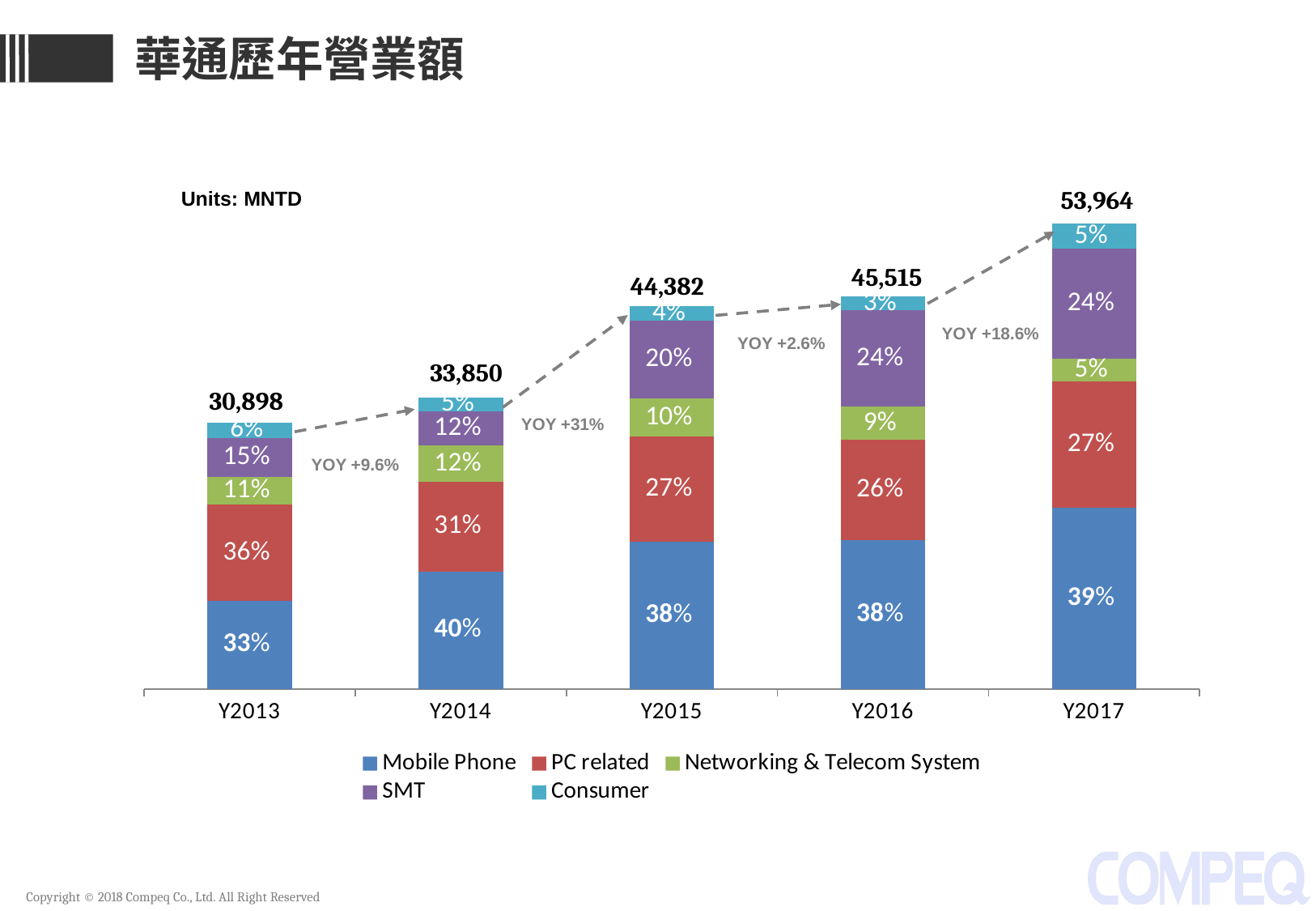
What percentage share does Mobile Phone have in Y2014? 40% Which year has the lowest total revenue? Y2013 What percentage share does SMT have in Y2016? 24% How many series does the legend list? 5 How many years are shown on the x axis? 5 What kind of chart is shown on the slide? Stacked bar chart Do the total revenue values rise or fall from Y2013 to Y2017? Rise What percentage share does PC related have in Y2013? 36% What is the difference between the total revenue in Y2015 and Y2014? 10,532 What is the total revenue shown above the bar for Y2017? 53,964 Which is larger, the PC related share in Y2014 or in Y2016? Y2014 Which year has the highest total revenue? Y2017